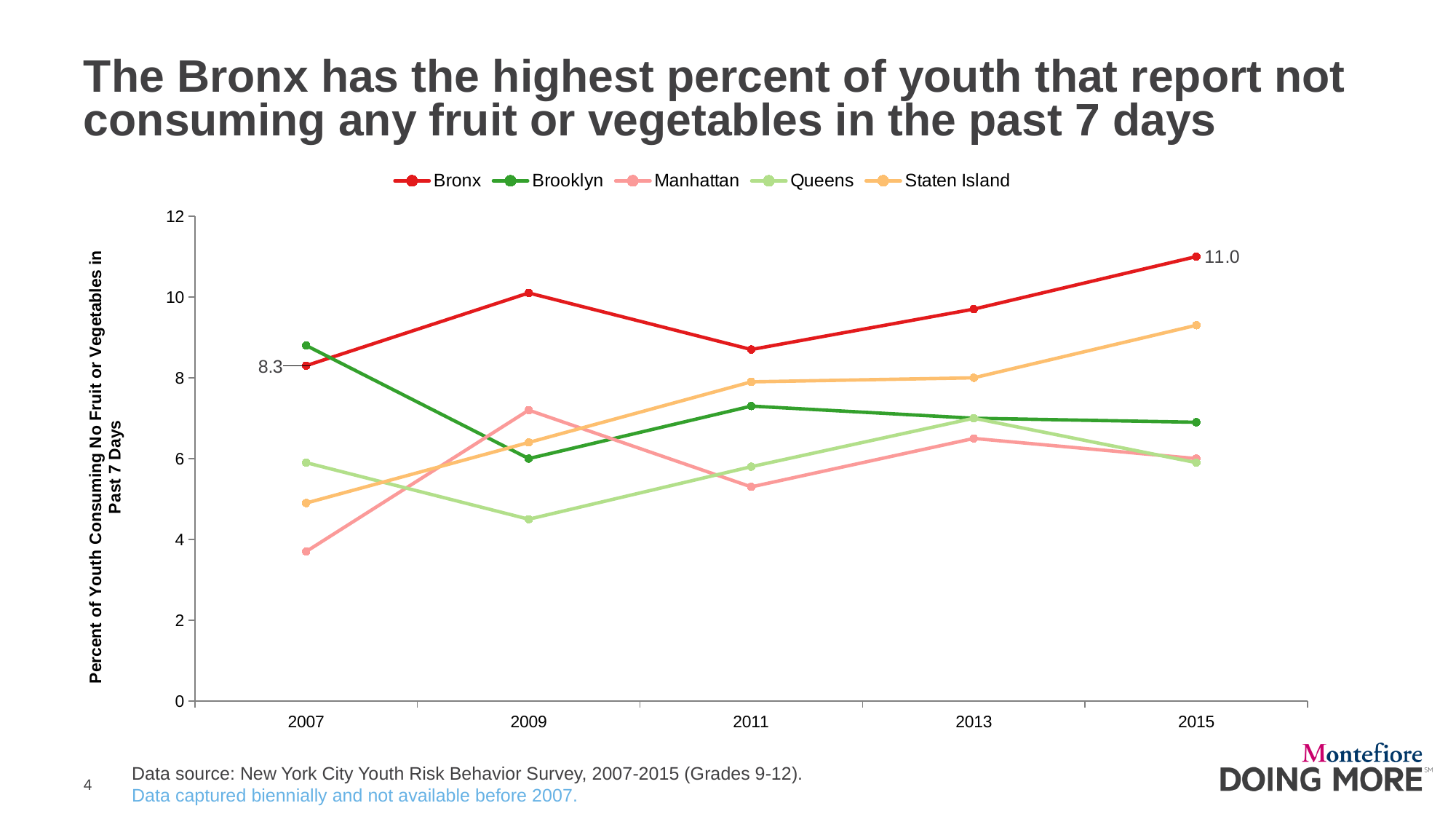
Which borough has the highest value in 2015? Bronx What is the value for the Bronx in 2007? 8.3 Which borough has the lowest value in 2007? Manhattan What kind of chart is shown on the slide? Line chart How many series does the legend list? 5 Is the value for Manhattan in 2007 greater or less than 4? less What is the value for the Bronx in 2015? 11.0 Does the Staten Island line rise or fall from 2007 to 2015? rise Is the value for Staten Island in 2015 greater or less than 8? greater In 2007, which is larger: the value for Brooklyn or the value for the Bronx? Brooklyn How many years are shown on the x axis? 5 By how much did the Bronx value increase from 2007 to 2015? 2.7